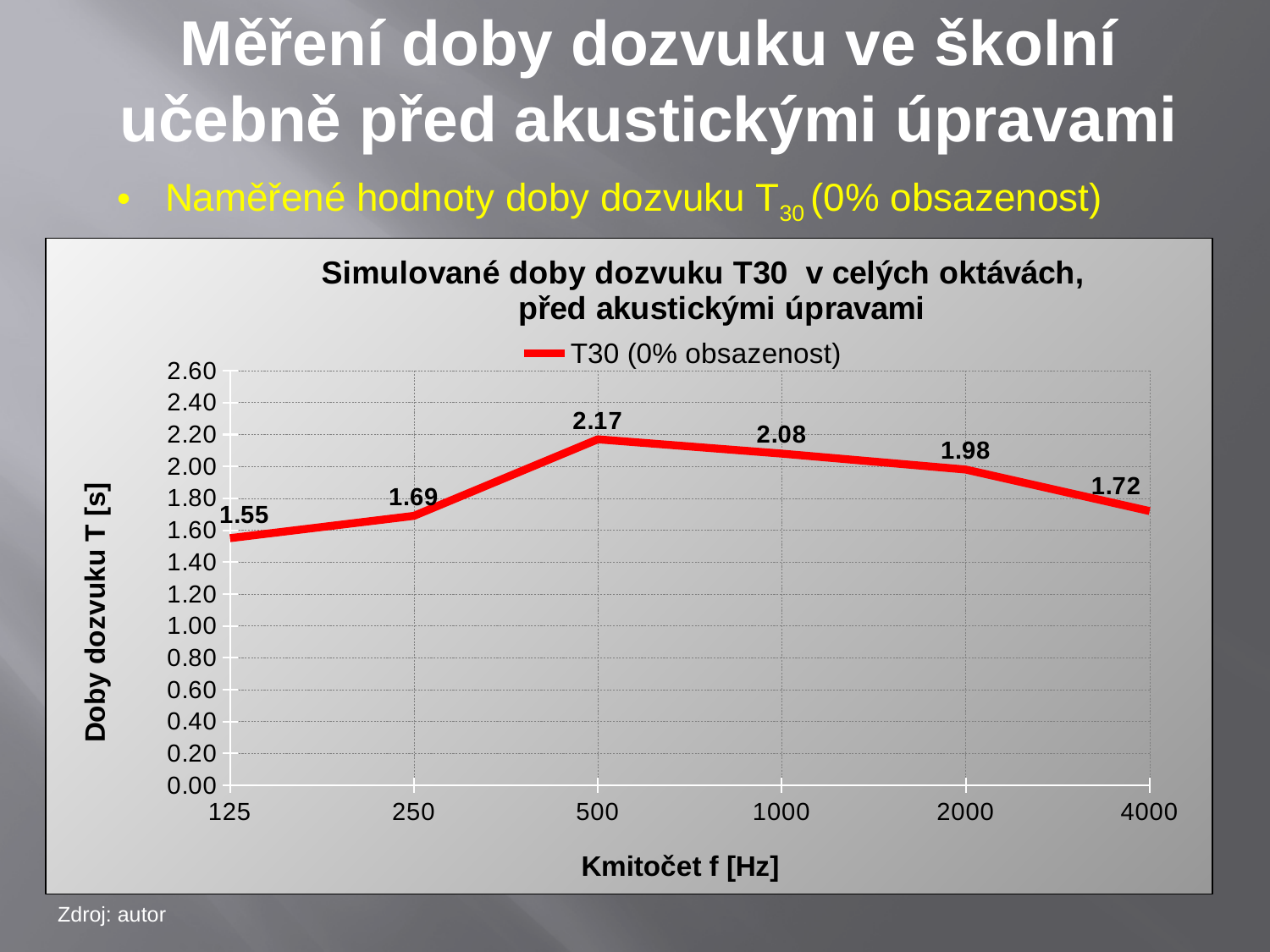
What is the T30 value at 125 Hz? 1.55 What is the difference between the T30 values at 500 Hz and 125 Hz? 0.62 Which has a larger T30 value, 1000 Hz or 2000 Hz? 1000 At which frequency is the reverberation time T30 highest? 500 What is the T30 value at 4000 Hz? 1.72 Is the T30 value at 250 Hz greater or less than 1.80? less What kind of chart is shown on the slide? line chart How many frequency points are plotted on the chart? 6 At which frequency is the reverberation time T30 lowest? 125 What is the label of the y axis? Doby dozvuku T [s] What is the T30 value at 500 Hz? 2.17 How many series does the legend list? 1